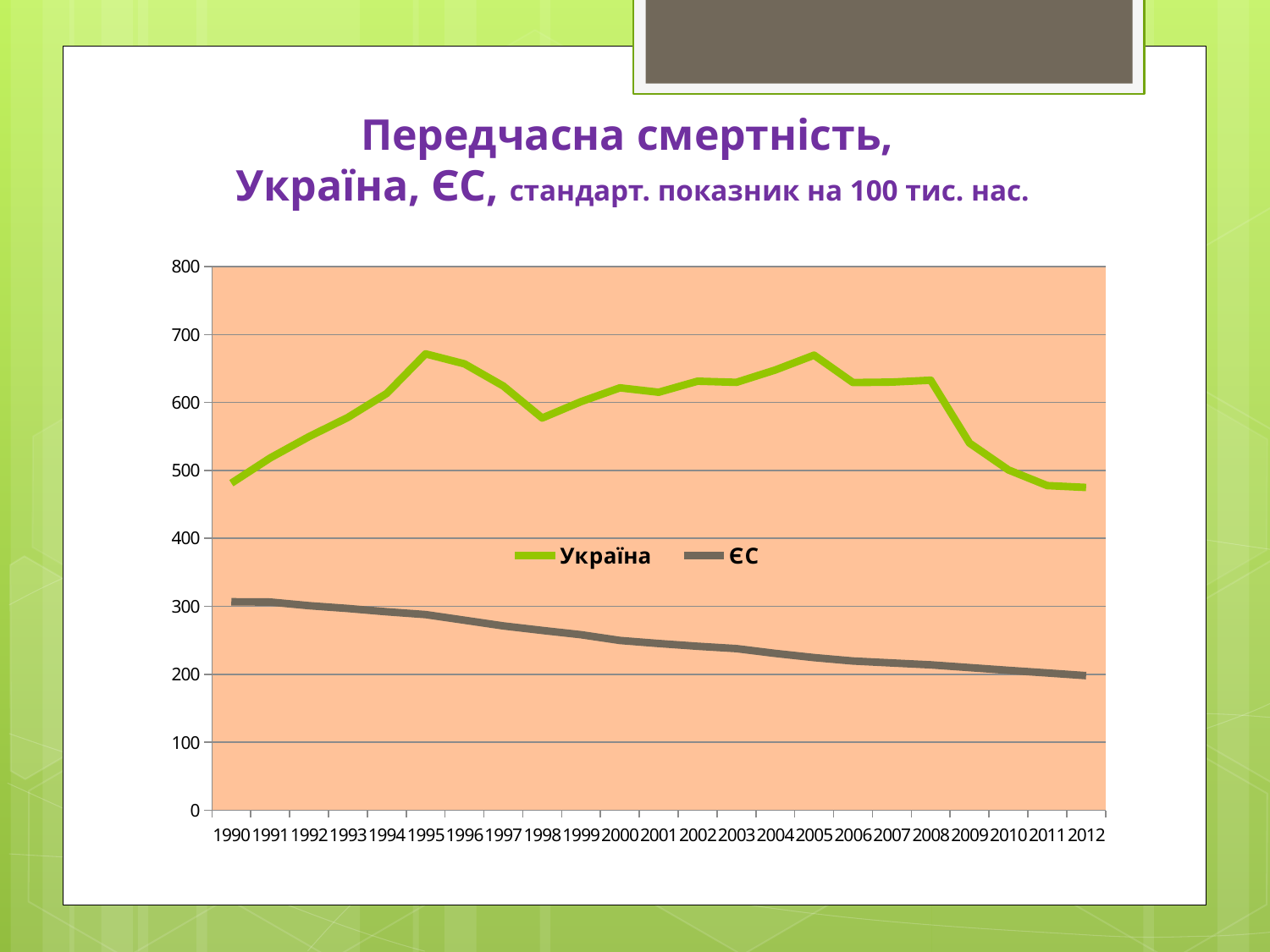
How many series does the legend list? 2 Is the value for ЄС in 1990 greater or less than 200? greater What is the first year shown on the x axis? 1990 In 2000, which series has the larger value, Україна or ЄС? Україна How many years are plotted along the x axis? 23 Does the value for ЄС rise or fall from 1990 to 2012? fall What kind of chart is shown on the slide? line chart Is the value for ЄС in 2000 greater or less than 300? less Which two series are listed in the legend? Україна and ЄС Is the value for Україна in 2008 greater or less than 600? greater